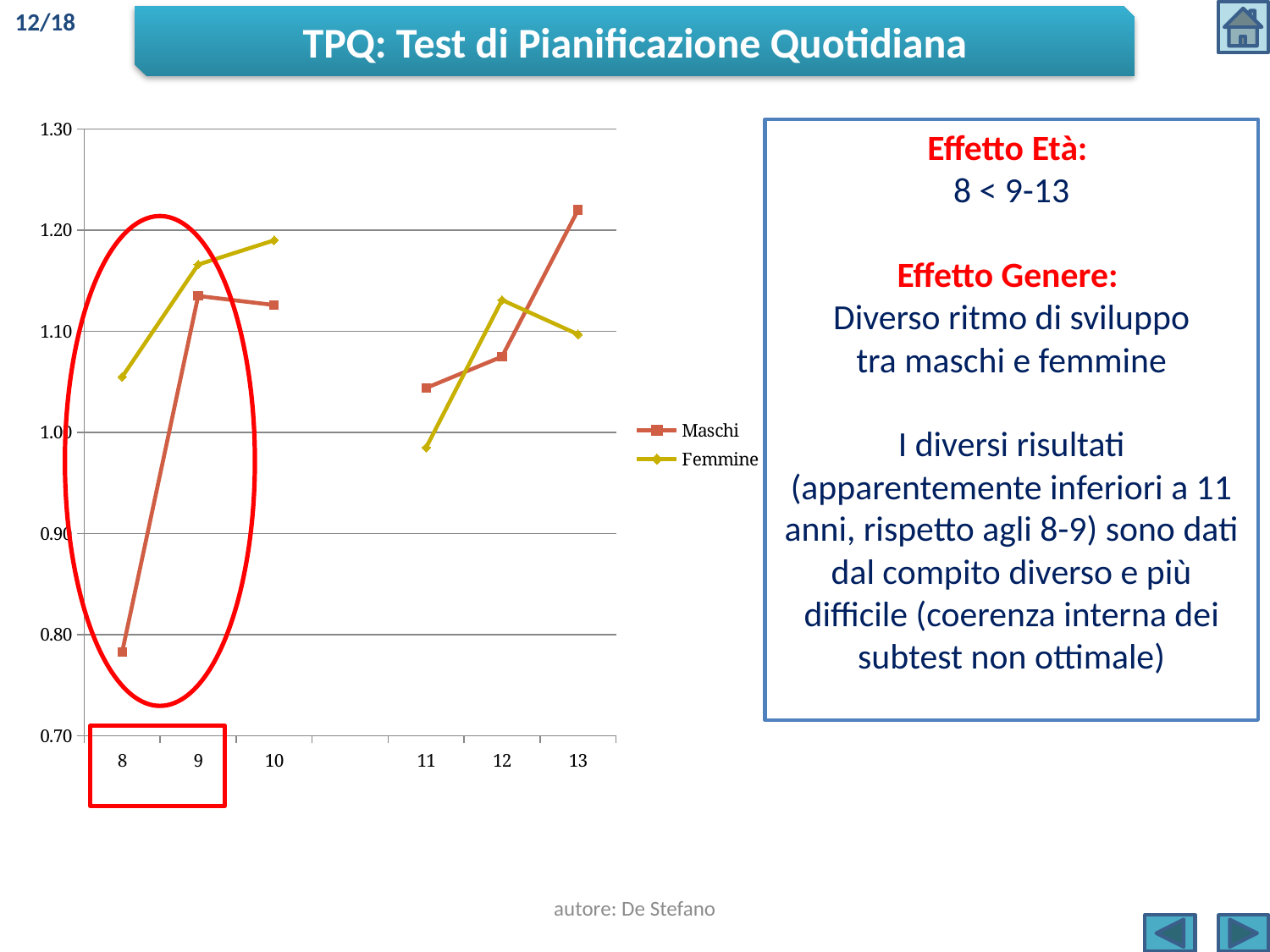
What are the two series named in the chart legend? Maschi and Femmine At age 13, which series has the higher value, Maschi or Femmine? Maschi Is the value for Maschi at age 8 greater or less than 0.80? less How many series does the chart legend list? 2 Does the Maschi series rise or fall from age 8 to age 9? rise Is the value for Femmine at age 10 greater or less than 1.10? greater Is the value for Femmine at age 8 greater or less than 1.00? greater How many age categories are shown on the x axis of the chart? 6 At age 8, which series has the higher value, Maschi or Femmine? Femmine What kind of chart is shown on the slide? line chart For the Maschi series, at which age is the value highest? 13 For the Maschi series, at which age is the value lowest? 8